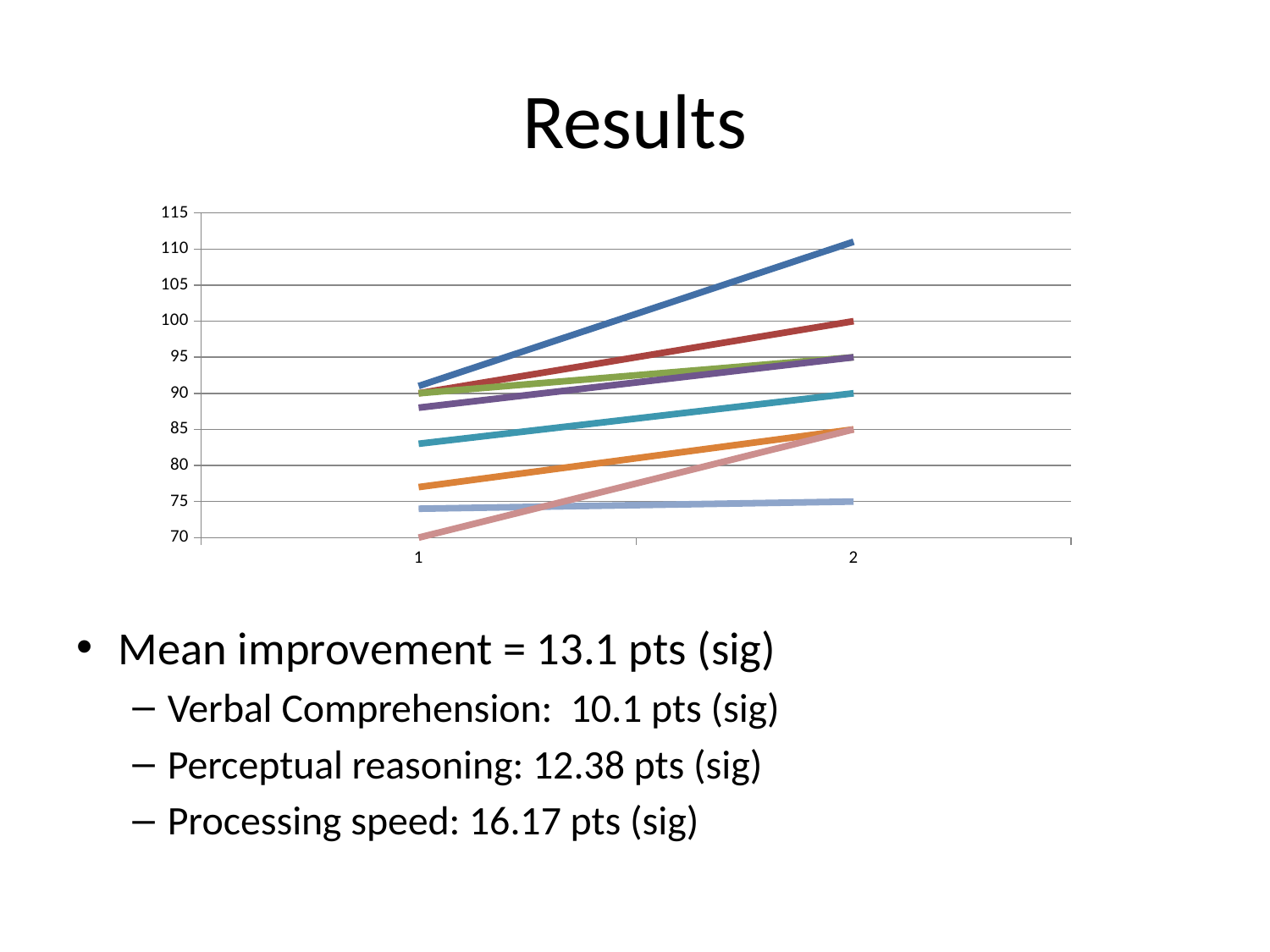
How many lines are plotted on the chart? 8 What is the lowest tick value shown on the y axis of the chart? 70 At point 1, is the dark blue line's value greater or less than the light blue line's value? greater What is the highest tick value shown on the y axis of the chart? 115 Is the value of the orange line at point 1 greater or less than 80? less Is the value of the pink line at point 1 greater or less than 75? less Is the value of the red line at point 2 greater or less than 95? greater Do most of the lines rise or fall from point 1 to point 2? rise How many points are labelled on the x axis of the chart? 2 Which line reaches the highest value at point 2? the dark blue line What kind of chart is shown on the slide? line chart